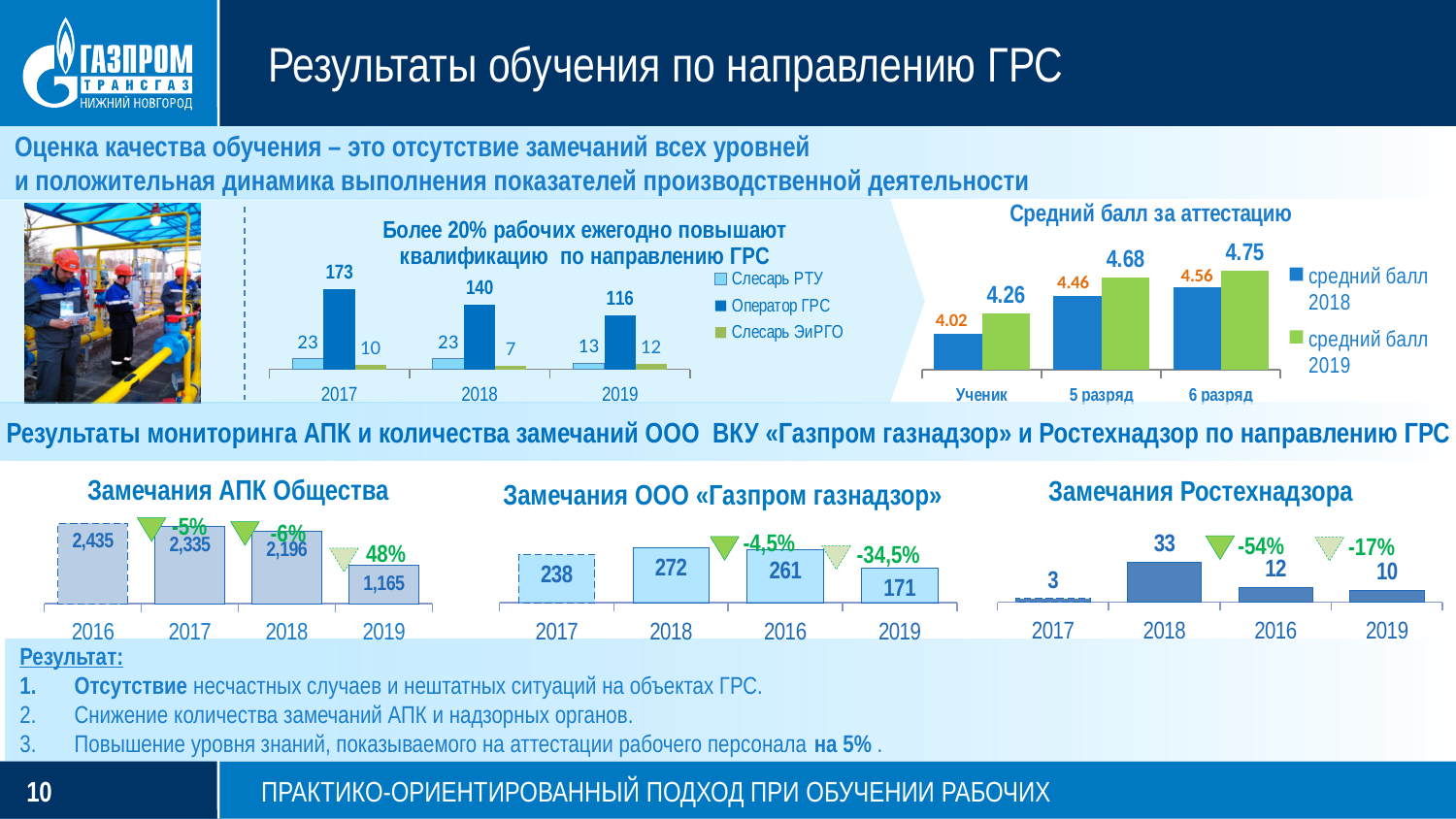
In the chart 'Более 20% рабочих ежегодно повышают квалификацию по направлению ГРС', what is the value for Оператор ГРС in 2017? 173 In the chart 'Замечания АПК Общества', what is the value for 2019? 1,165 In the chart 'Средний балл за аттестацию', which category has the lowest средний балл 2018 value? Ученик In the chart 'Более 20% рабочих ежегодно повышают квалификацию по направлению ГРС', does the Оператор ГРС value rise or fall from 2017 to 2019? fall In the chart 'Более 20% рабочих ежегодно повышают квалификацию по направлению ГРС', how many series does the legend list? 3 In the chart 'Средний балл за аттестацию', what is the средний балл 2019 value for 6 разряд? 4.75 In the chart 'Замечания Ростехнадзора', which year has the highest value? 2018 In the chart 'Средний балл за аттестацию', what is the difference between the 2019 and 2018 values for 5 разряд? 0.22 In the chart 'Более 20% рабочих ежегодно повышают квалификацию по направлению ГРС', what is the difference between the Оператор ГРС values for 2018 and 2019? 24 What type of chart is 'Замечания Ростехнадзора'? bar chart In the chart 'Замечания ООО «Газпром газнадзор»', what is the value for 2018? 272 In the chart 'Замечания АПК Общества', which year has the highest value? 2016